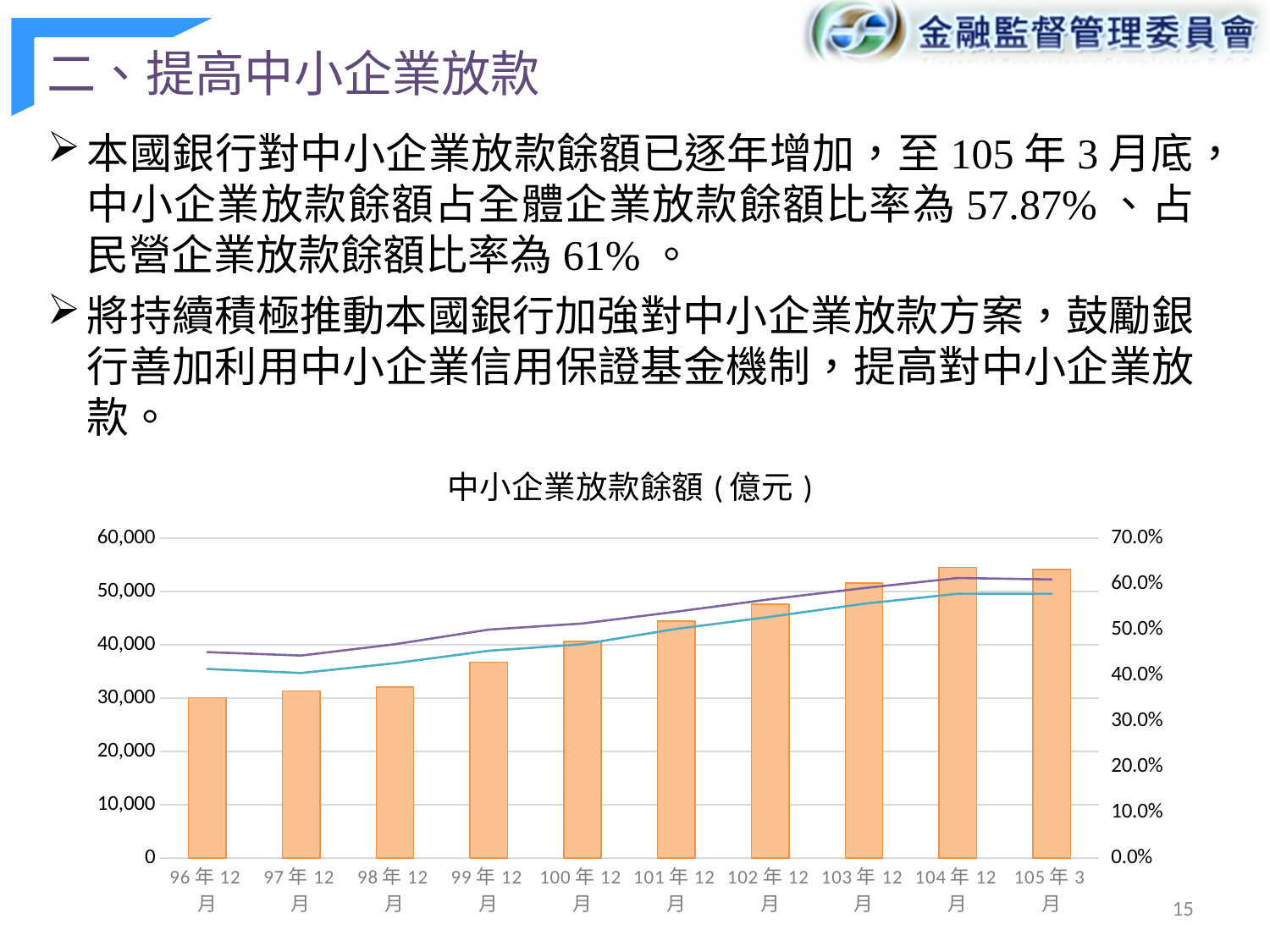
Which period has the lowest bar in the chart? 96 年 12 月 What kind of chart is shown on the slide? A combined bar and line chart Do the bar values generally rise or fall from 96 年 12 月 to 105 年 3 月? Rise Is the bar value for 102 年 12 月 greater or less than 50,000? less How many time periods are shown on the x axis of the chart? 10 Is the bar value for 101 年 12 月 greater or less than 40,000? greater Which has the larger bar value, 100 年 12 月 or 96 年 12 月? 100 年 12 月 What is the highest tick value shown on the right-hand percentage axis? 70.0% What is the title of the chart? 中小企業放款餘額（億元） Is the bar value for 96 年 12 月 greater or less than 40,000? less Which has the larger bar value, 103 年 12 月 or 99 年 12 月? 103 年 12 月